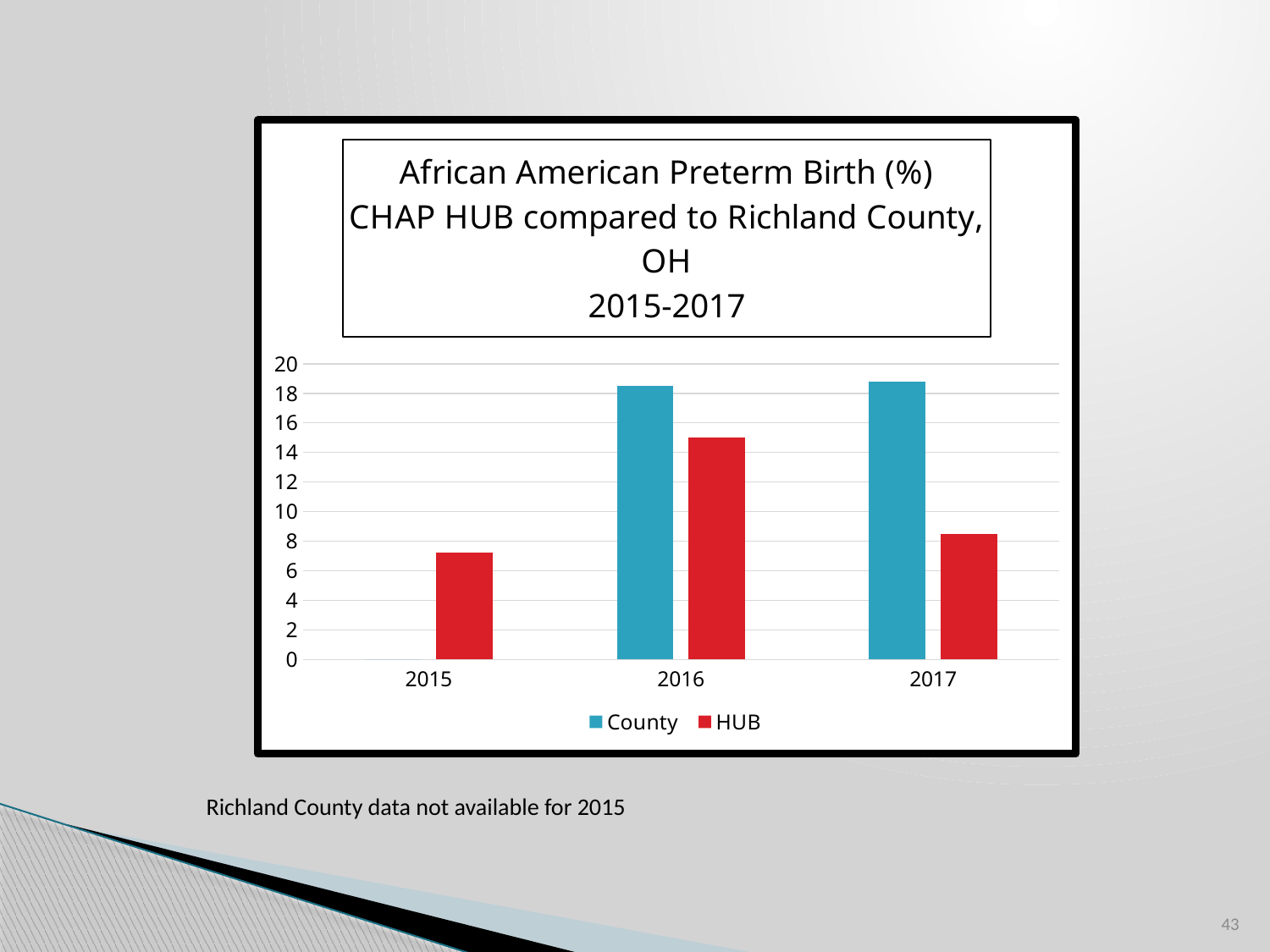
Which year has the highest HUB value? 2016 What kind of chart is shown on the slide? bar chart In 2016, which is larger, the County value or the HUB value? County Which year has the lowest HUB value? 2015 Is the HUB value for 2016 greater or less than 16? less Does the HUB value rise or fall from 2016 to 2017? fall Which series is shown in red in the legend? HUB Is the HUB value for 2015 greater or less than 8? less Is the HUB value for 2017 greater or less than 10? less How many series does the legend list? 2 How many years are shown on the x axis? 3